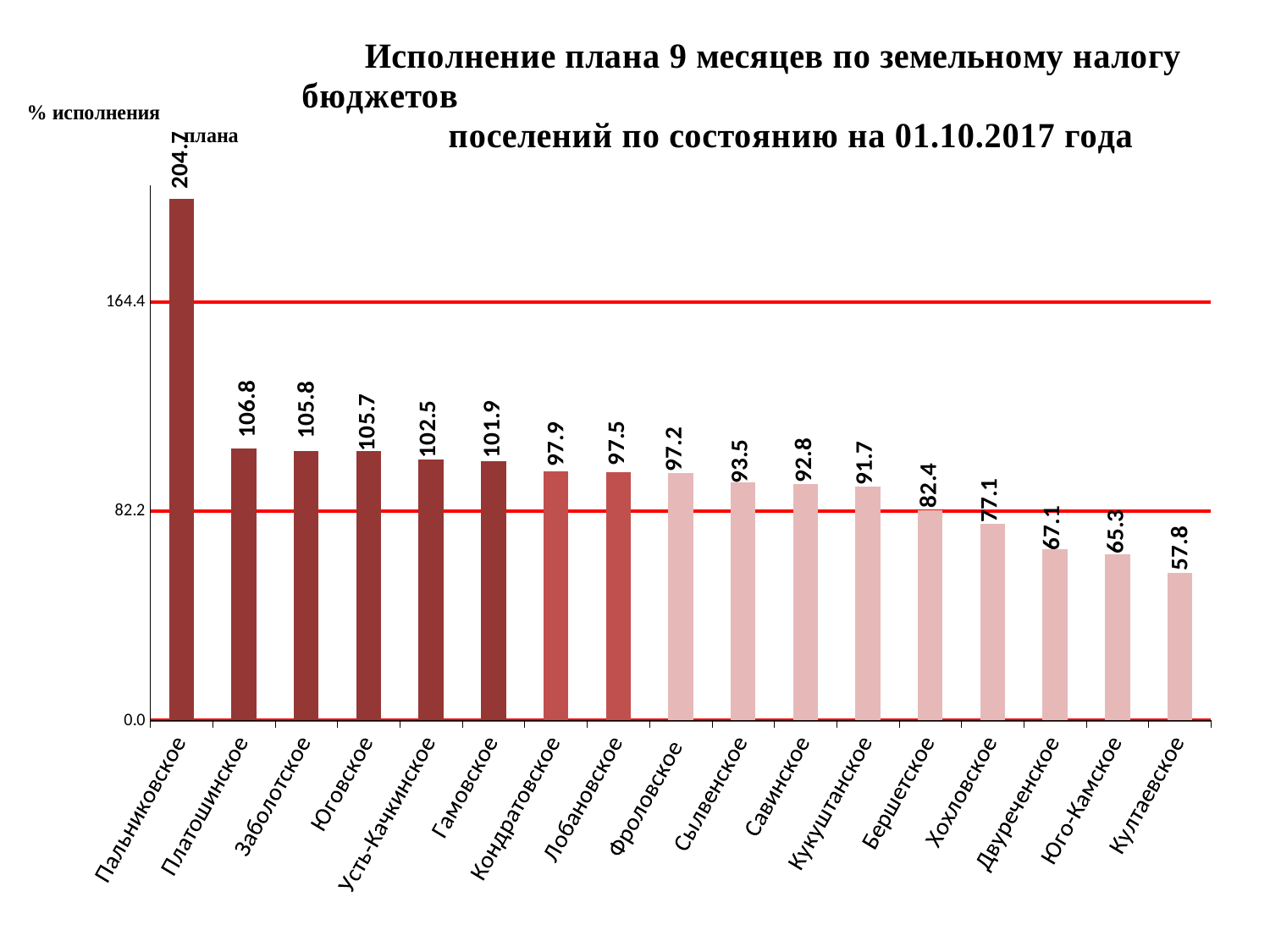
What is the label on the vertical axis? % исполнения плана Which category has the highest value? Пальниковское What is the value for Пальниковское? 204.7 What is the difference between the values for Пальниковское and Гамовское? 102.8 What type of chart is shown on the slide? bar chart Which is larger, the value for Сылвенское or the value for Двуреченское? Сылвенское What is the value for Кукуштанское? 91.7 Do the values generally rise or fall from left to right along the x axis? fall How many categories are shown on the x axis? 17 What is the difference between the values for Платошинское and Култаевское? 49.0 What is the value for Хохловское? 77.1 Which category has the lowest value? Култаевское